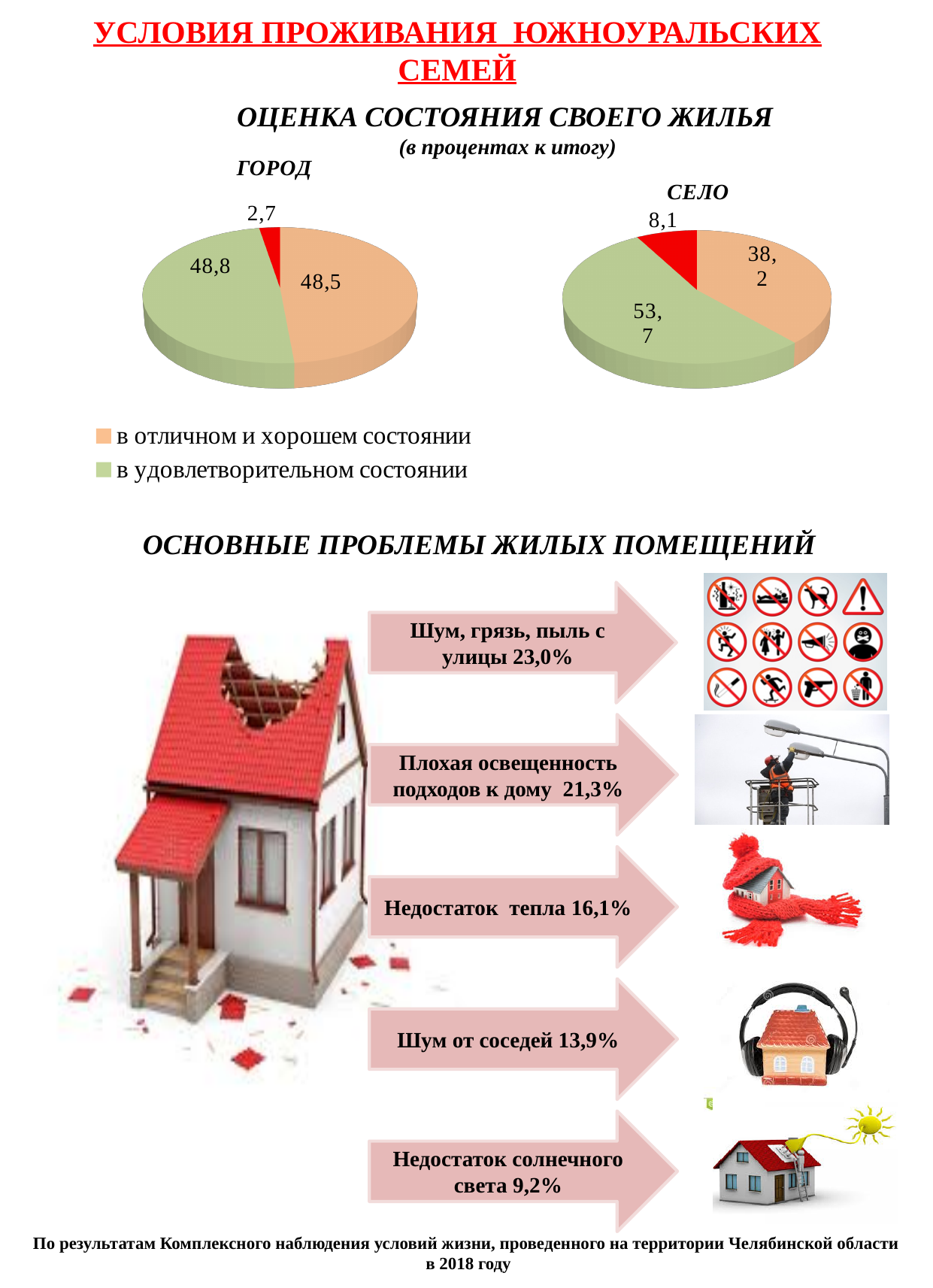
In the СЕЛО pie chart, what is the value of the red slice? 8,1 How many entries does the legend below the pie charts list? 2 In the ГОРОД pie chart, what is the value for the slice 'в удовлетворительном состоянии'? 48,8 In the ГОРОД pie chart, which slice is the smallest? The red slice (2,7) In the СЕЛО pie chart, which category has the largest share? в удовлетворительном состоянии In the ГОРОД pie chart, what is the value for the slice 'в отличном и хорошем состоянии'? 48,5 In the СЕЛО pie chart, what is the value for the slice 'в отличном и хорошем состоянии'? 38,2 What is the difference between the 'в удовлетворительном состоянии' values in the СЕЛО and ГОРОД pie charts? 4,9 Which pie chart has the larger red slice, ГОРОД or СЕЛО? СЕЛО What kind of charts are shown under the heading ОЦЕНКА СОСТОЯНИЯ СВОЕГО ЖИЛЬЯ? Pie charts How many slices does each pie chart have? 3 In the СЕЛО pie chart, what is the value for the slice 'в удовлетворительном состоянии'? 53,7